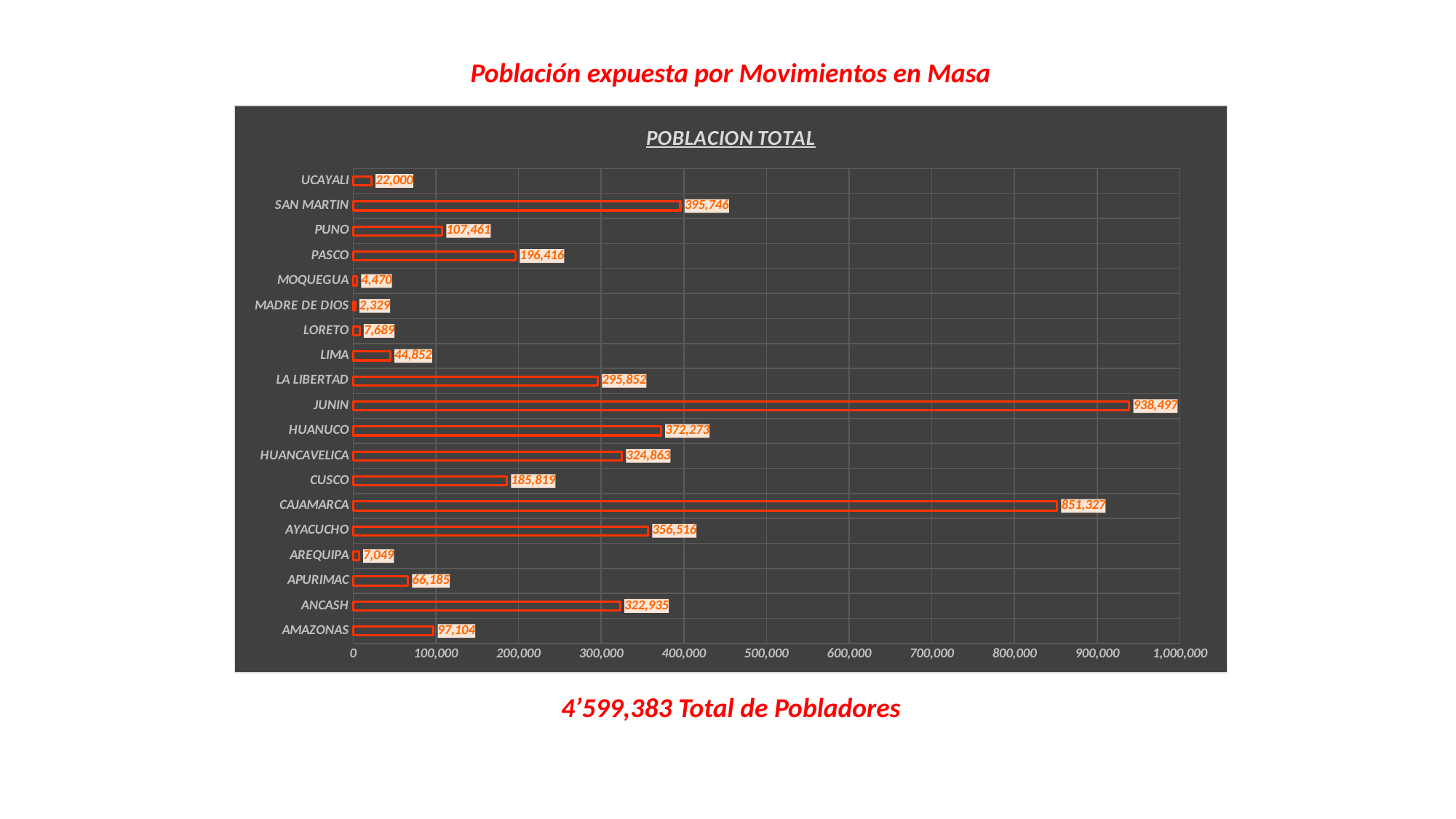
What is the difference between the values for SAN MARTIN and HUANUCO? 23,473 What is the value for PASCO? 196,416 Which is larger, the value for AYACUCHO or the value for LA LIBERTAD? AYACUCHO Is the value for CAJAMARCA greater or less than 800,000? greater Which category has the highest value? JUNIN What is the difference between the values for JUNIN and CAJAMARCA? 87,170 Which category has the lowest value? MADRE DE DIOS What is the value for JUNIN? 938,497 What is the title of the chart? POBLACION TOTAL What is the value for MADRE DE DIOS? 2,329 How many categories are shown in the chart? 19 What kind of chart is shown? Bar chart